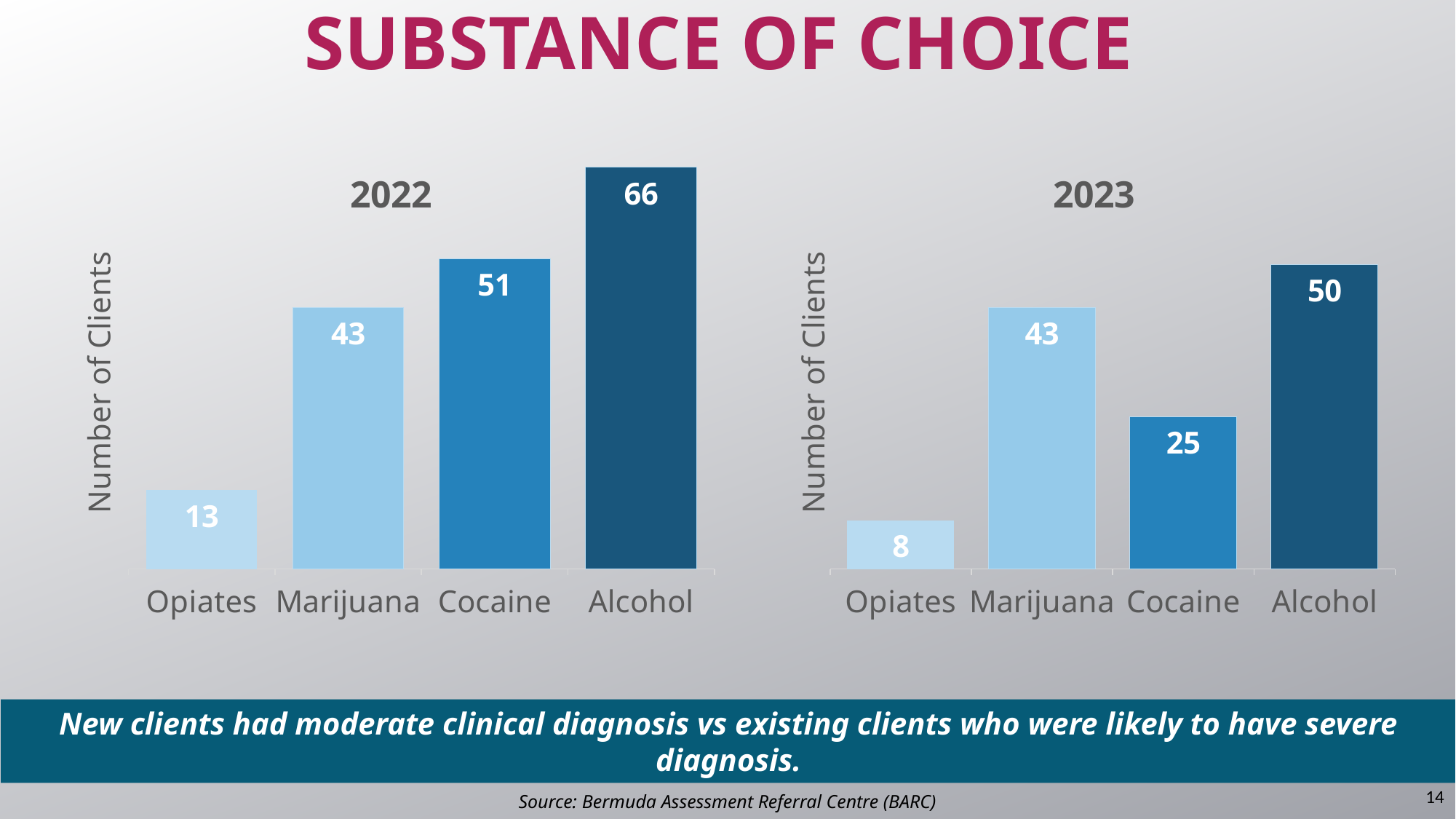
Which is larger: the Cocaine value in the 2022 chart or the Cocaine value in the 2023 chart? 2022 What is the y-axis label on the 2022 chart? Number of Clients In the 2022 chart, how many substance categories are shown? 4 In the 2023 chart, what is the difference between the Alcohol and Cocaine values? 25 In the 2022 chart, how many clients chose Alcohol? 66 What type of chart is the 2023 chart? Bar chart In the 2022 chart, do the values rise or fall from Opiates to Alcohol along the x axis? Rise In the 2022 chart, which substance has the highest number of clients? Alcohol In the 2023 chart, which substance has the lowest number of clients? Opiates In the 2023 chart, how many clients chose Cocaine? 25 In the 2023 chart, what is the value for Opiates? 8 In the 2022 chart, what is the difference between the Cocaine and Marijuana values? 8